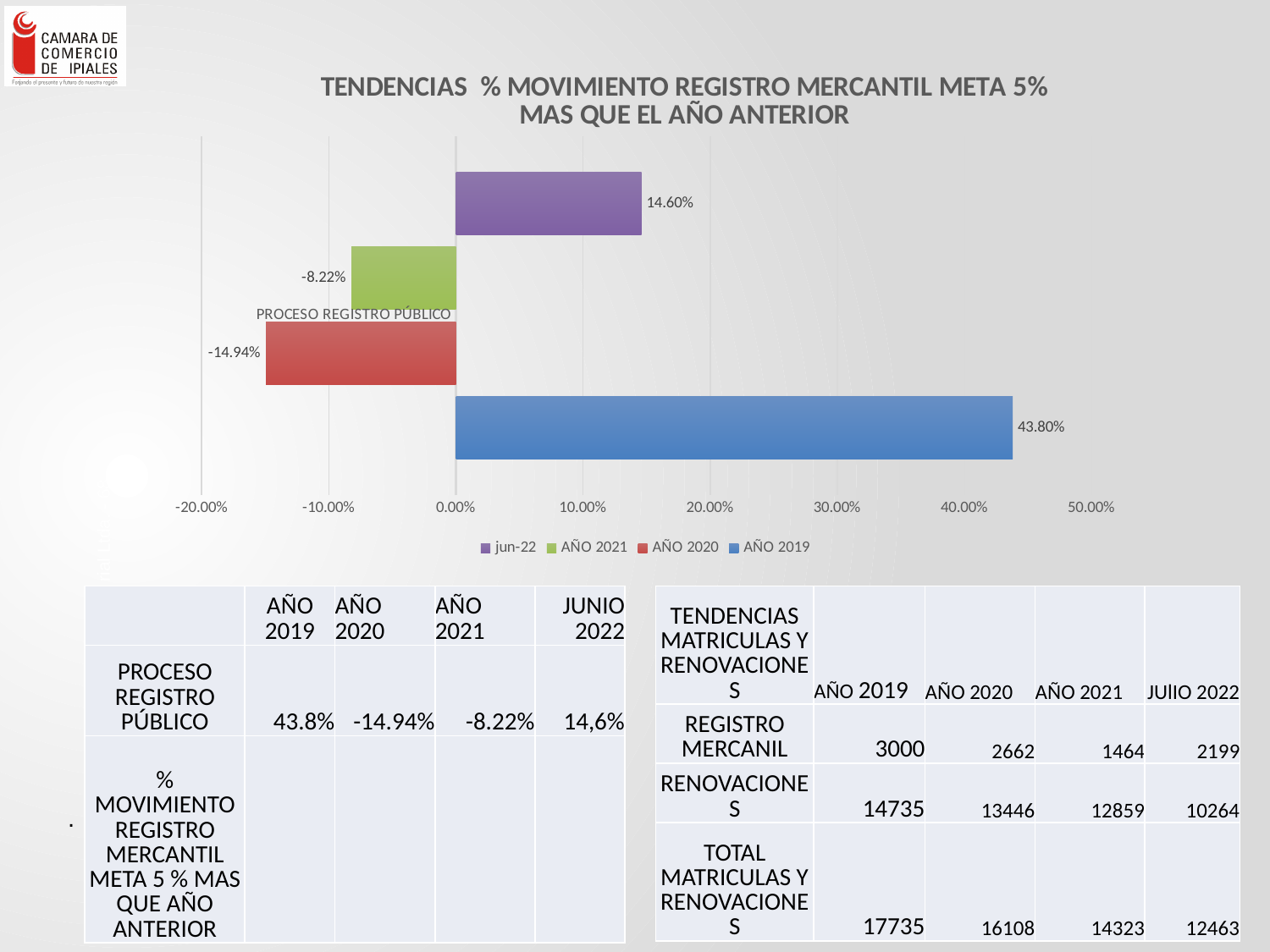
What is the value for the AÑO 2019 series in the chart? 43.80% Which series has the highest value in the chart? AÑO 2019 Which series has the lowest value in the chart? AÑO 2020 What colour is the bar for the AÑO 2020 series? red Which is larger, the value for jun-22 or the value for AÑO 2021? jun-22 What is the value for the AÑO 2020 series in the chart? -14.94% How many series does the chart legend list? 4 What is the difference between the AÑO 2019 value and the jun-22 value? 29.20% Is the value for AÑO 2019 greater or less than 40.00%? greater What is the value for the AÑO 2021 series in the chart? -8.22% What kind of chart is shown on the slide? bar chart What is the value for the jun-22 series in the chart? 14.60%